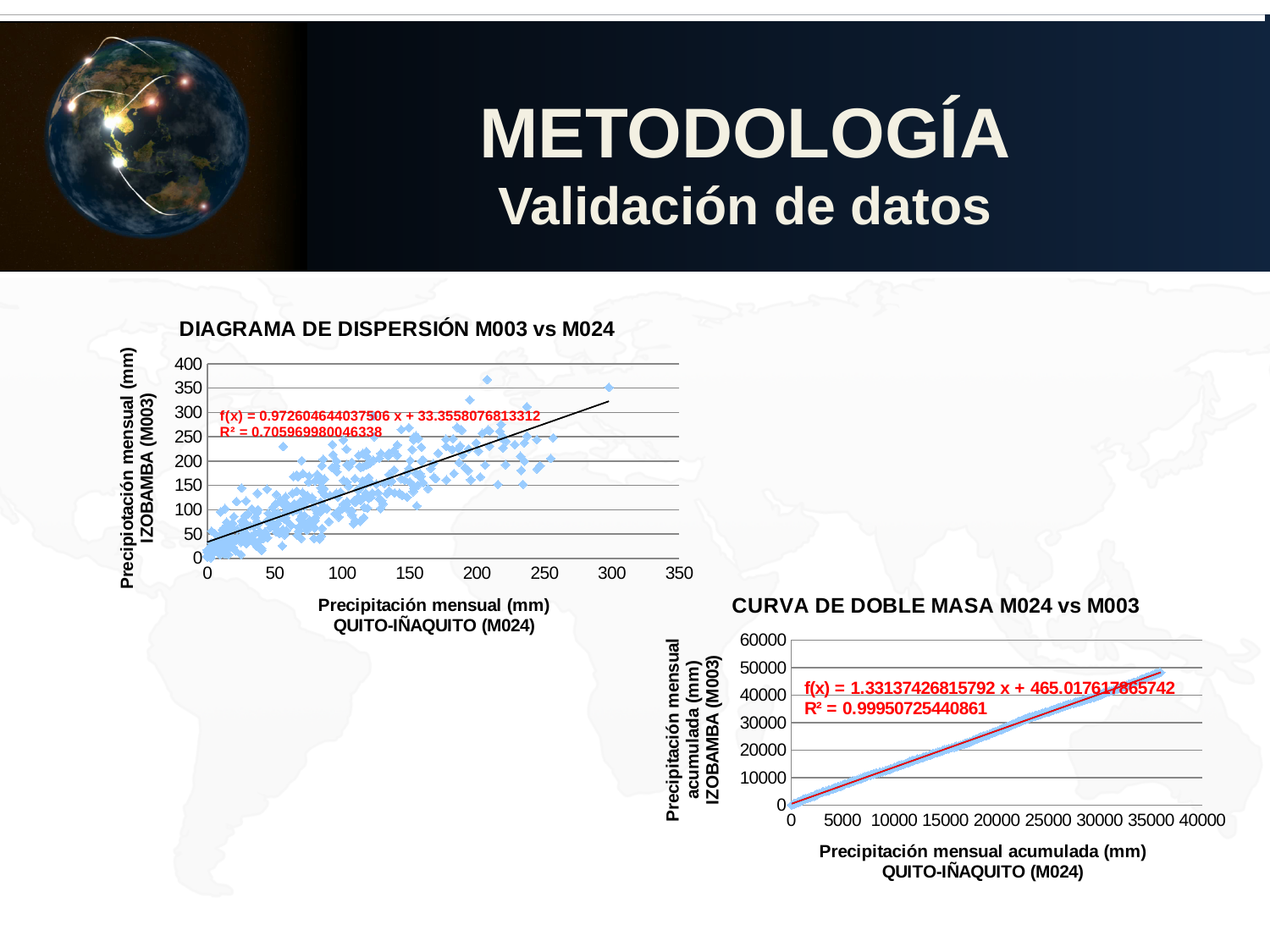
What kind of chart is the 'CURVA DE DOBLE MASA M024 vs M003' chart? Scatter plot In the 'DIAGRAMA DE DISPERSIÓN M003 vs M024' chart, what is the slope of the fitted line f(x)? 0.972604644037506 In the 'CURVA DE DOBLE MASA M024 vs M003' chart, what is the R² value shown? 0.99950725440861 In the 'CURVA DE DOBLE MASA M024 vs M003' chart, what is the intercept of the fitted line f(x)? 465.017617865742 In the 'DIAGRAMA DE DISPERSIÓN M003 vs M024' chart, do the values generally rise or fall as the x-axis value increases? Rise What is the highest value shown on the y axis of the 'CURVA DE DOBLE MASA M024 vs M003' chart? 60000 Which chart has the higher R² value, the 'DIAGRAMA DE DISPERSIÓN M003 vs M024' chart or the 'CURVA DE DOBLE MASA M024 vs M003' chart? CURVA DE DOBLE MASA M024 vs M003 In the 'CURVA DE DOBLE MASA M024 vs M003' chart, do the values rise or fall along the x axis? Rise What is the x-axis label of the 'DIAGRAMA DE DISPERSIÓN M003 vs M024' chart? Precipitación mensual (mm) QUITO-IÑAQUITO (M024) In the 'DIAGRAMA DE DISPERSIÓN M003 vs M024' chart, what is the R² value shown? 0.705969980046338 What kind of chart is the 'DIAGRAMA DE DISPERSIÓN M003 vs M024' chart? Scatter plot In the 'CURVA DE DOBLE MASA M024 vs M003' chart, is the accumulated M003 value at an accumulated M024 value of 35000 greater or less than 40000? greater